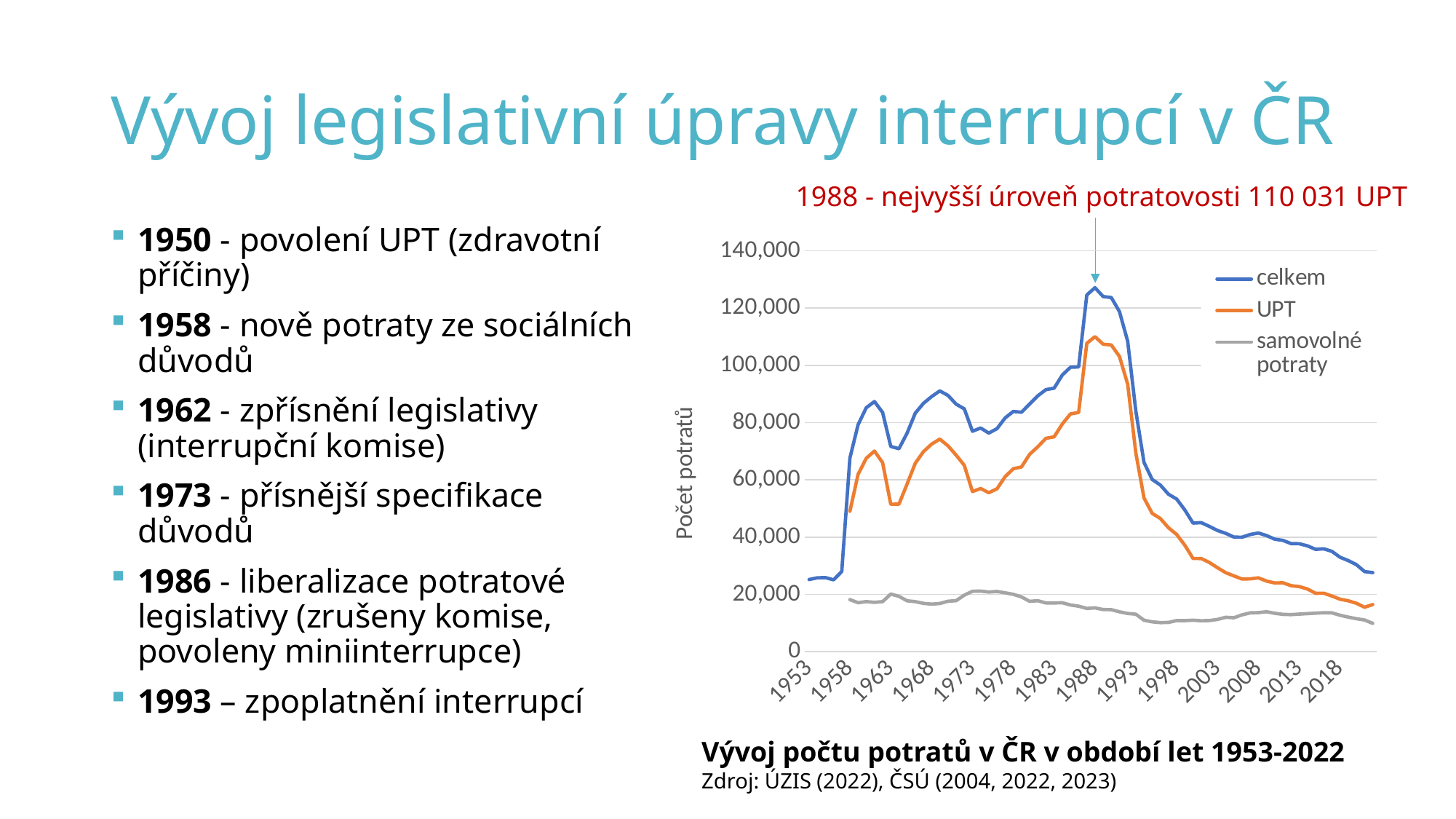
Is the value of the samovolné potraty series in 1988 greater or less than 20,000? less Is the value of the UPT series in 2018 greater or less than 40,000? less How many series does the chart legend list? 3 What kind of chart is shown on the slide? line chart Does the celkem series rise or fall between 1988 and 2018? fall What are the three series listed in the chart legend? celkem, UPT, samovolné potraty What was the number of UPT in 1988 according to the annotation on the chart? 110 031 Is the value of the celkem series in 1988 greater or less than 120,000? greater Which series has the lowest values across the whole period? samovolné potraty In which year did the UPT series reach its highest value? 1988 Which series is larger in 2018, celkem or samovolné potraty? celkem What is the title of the chart? Vývoj počtu potratů v ČR v období let 1953-2022